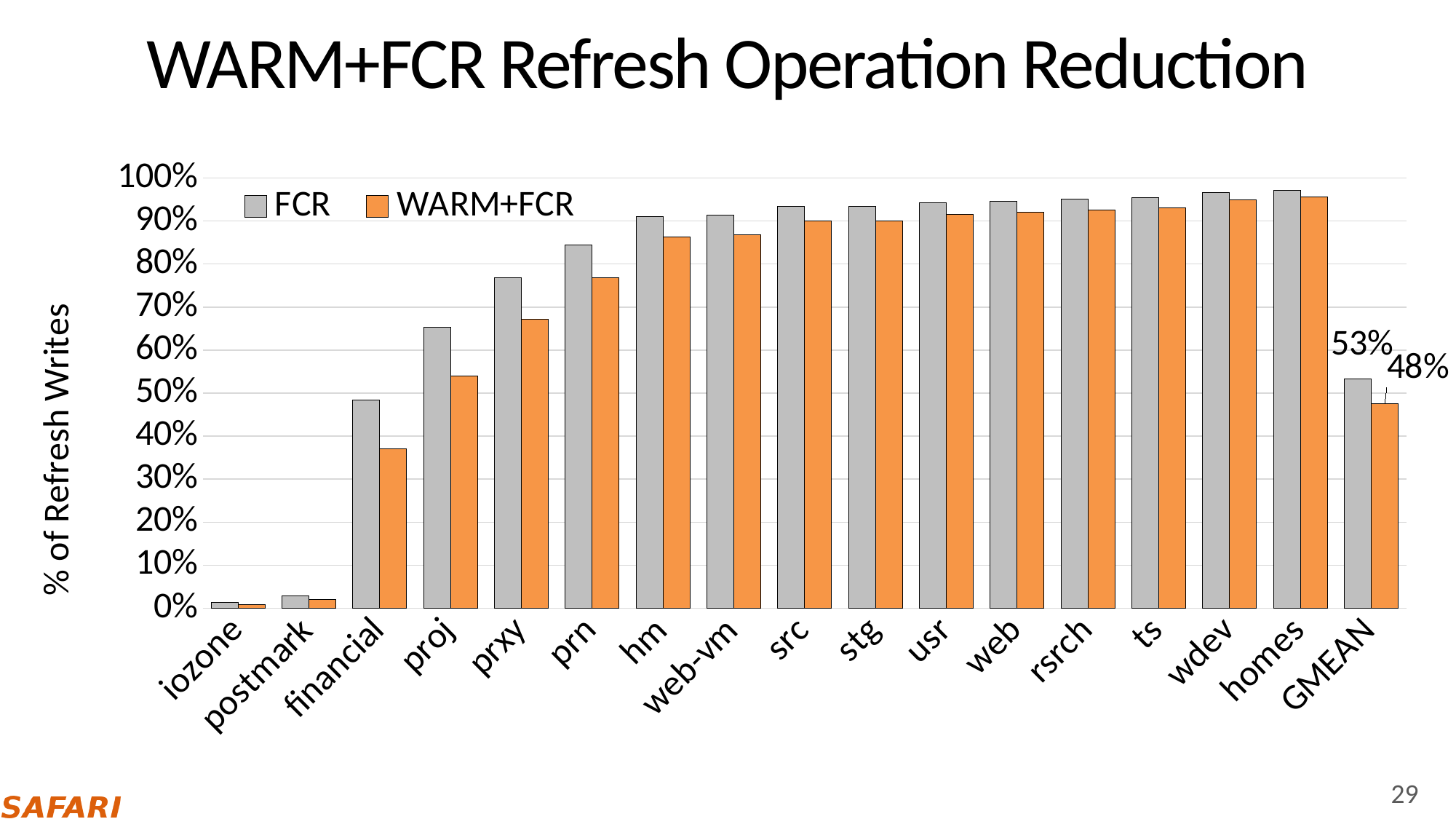
Which category has the lowest FCR value? iozone What kind of chart is shown on the slide? bar chart Is the WARM+FCR value for financial greater or less than 40%? less How many series does the legend list? 2 Is the FCR value for prn greater or less than 80%? greater Which has the larger FCR value, proj or prxy? prxy What is the WARM+FCR value for GMEAN? 48% What is the difference between the FCR and WARM+FCR values for GMEAN? 5% How many categories are shown on the x axis? 17 What is the label of the y axis? % of Refresh Writes For financial, which series has the larger value, FCR or WARM+FCR? FCR What is the FCR value for GMEAN? 53%